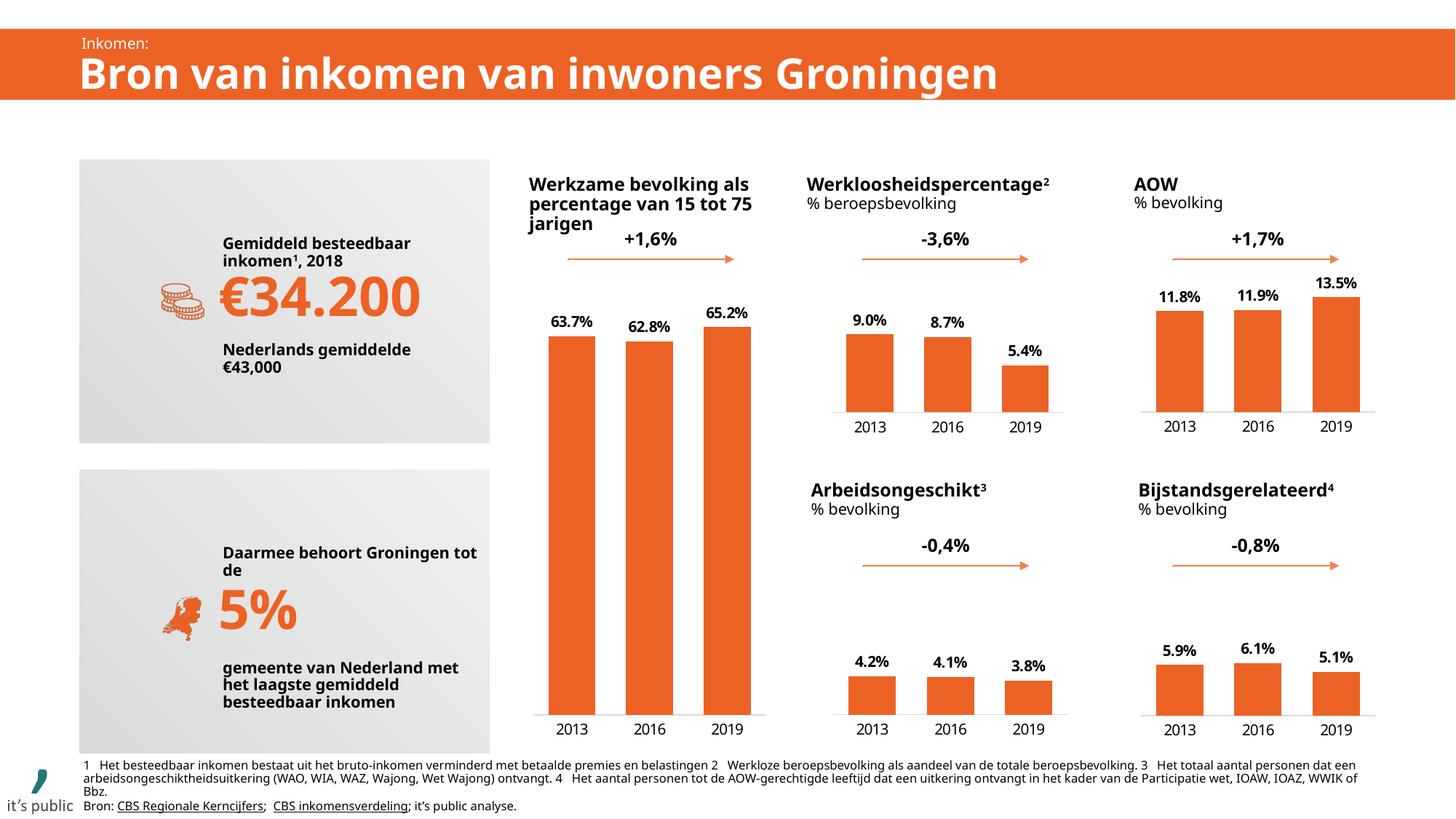
In the 'Arbeidsongeschikt' chart, what is the value for 2019? 3.8% What kind of chart is the 'Bijstandsgerelateerd' chart? bar chart In the 'Werkloosheidspercentage' chart, what is the difference between the 2013 and 2019 values? 3.6% In the 'Werkzame bevolking als percentage van 15 tot 75 jarigen' chart, which year has the lowest value? 2016 In the 'AOW' chart, what is the value for 2016? 11.9% In the 'AOW' chart, is the value for 2019 larger or smaller than the value for 2013? larger In the 'Werkloosheidspercentage' chart, what is the value for 2013? 9.0% How many years are shown on the x axis of the 'Arbeidsongeschikt' chart? 3 What change is shown by the arrow above the 'AOW' chart? +1,7% In the 'Werkloosheidspercentage' chart, do the values rise or fall from 2013 to 2019? fall In the 'Bijstandsgerelateerd' chart, which year has the highest value? 2016 In the 'Werkzame bevolking als percentage van 15 tot 75 jarigen' chart, what is the value for 2019? 65.2%